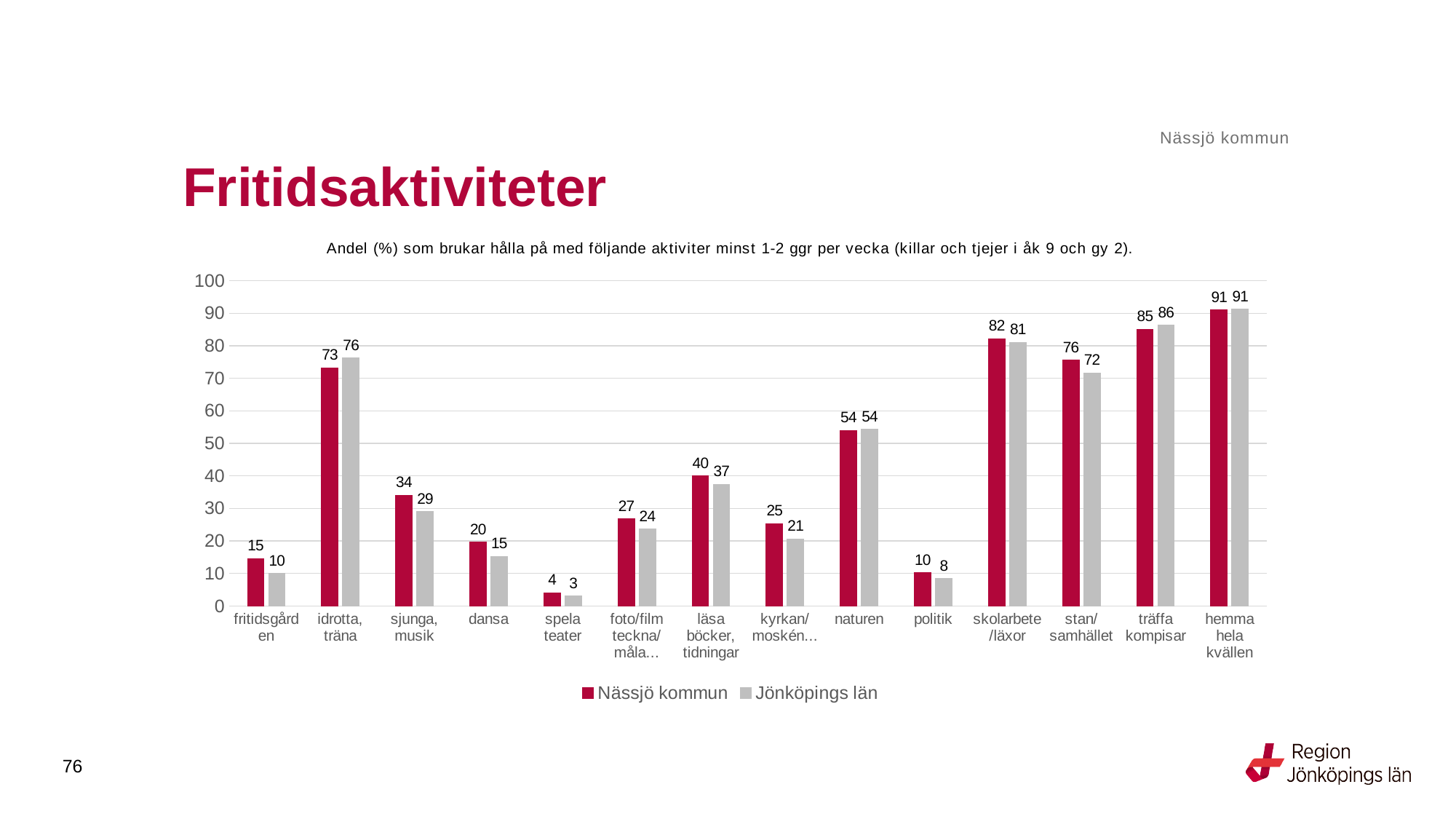
Which colour represents Nässjö kommun in the chart? red What is the value for Jönköpings län for 'naturen'? 54 What is the value for Nässjö kommun for 'idrotta, träna'? 73 How many activity categories are shown on the x axis? 14 For 'stan/samhället', which is larger: Nässjö kommun or Jönköpings län? Nässjö kommun What kind of chart is shown on the slide? bar chart What is the difference between Nässjö kommun and Jönköpings län for 'sjunga, musik'? 5 Which activity has the highest value for Nässjö kommun? hemma hela kvällen How many series does the legend list? 2 Which activity has the lowest value for Jönköpings län? spela teater What is the value for Jönköpings län for 'politik'? 8 Is the value for Nässjö kommun for 'skolarbete/läxor' greater or less than 80? greater